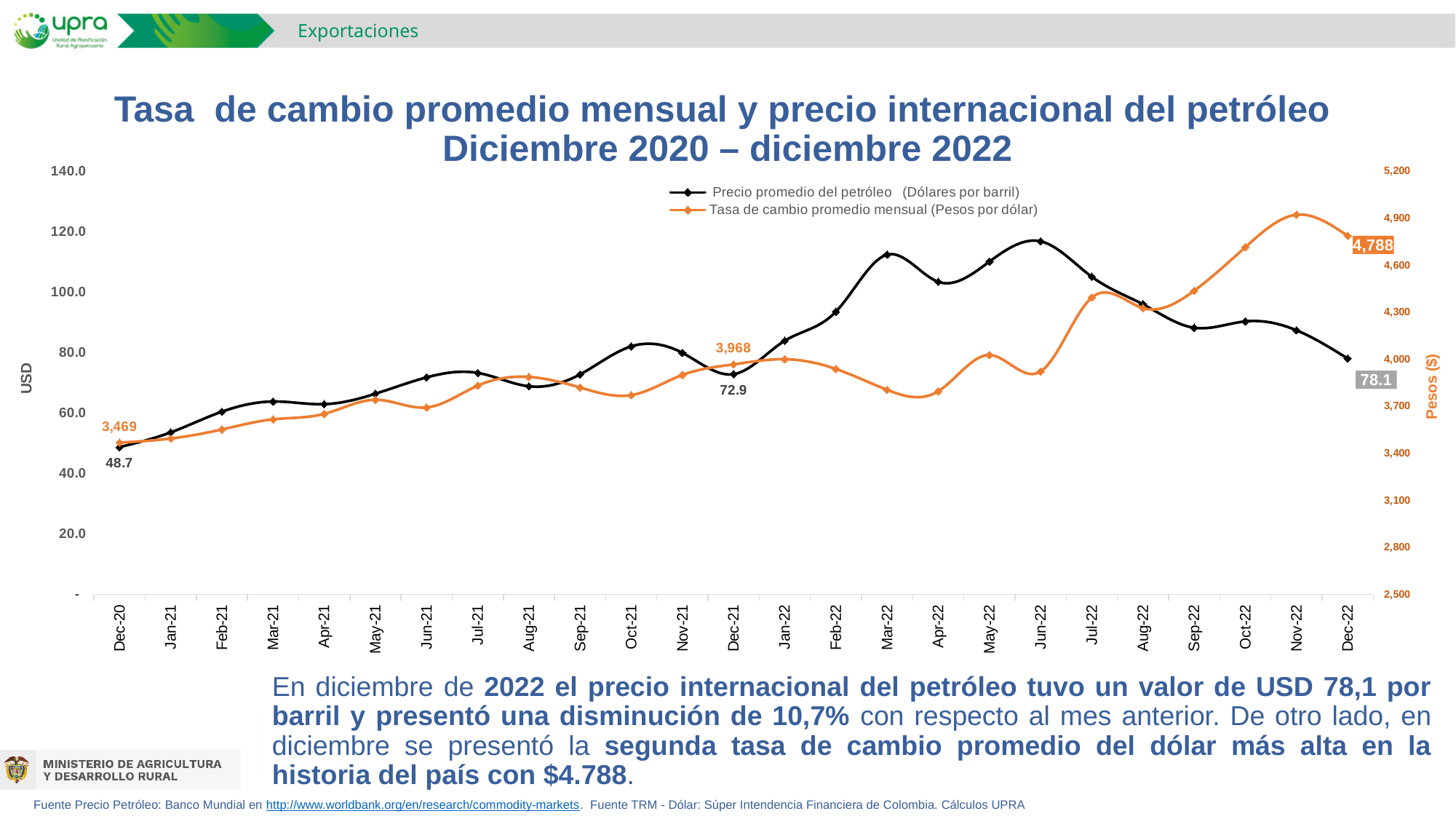
What was the Tasa de cambio promedio mensual (Pesos por dólar) in Dec-21? 3,968 In which month was the Precio promedio del petróleo lowest? Dec-20 What was the Tasa de cambio promedio mensual (Pesos por dólar) in Dec-22? 4,788 What was the average oil price (Dólares por barril) in Dec-22? 78.1 By how much did the average oil price in Dec-22 exceed the value in Dec-20? 29.4 What kind of chart is shown on the slide? Line chart In which month was the Tasa de cambio promedio mensual highest? Nov-22 How many series does the legend list? 2 What is the difference between the exchange rate in Dec-22 and in Dec-20? 1,319 What was the average oil price (Dólares por barril) in Dec-20? 48.7 Is the average oil price for Mar-22 greater or less than 100.0? greater Which month had the higher average oil price, Dec-21 or Dec-22? Dec-22